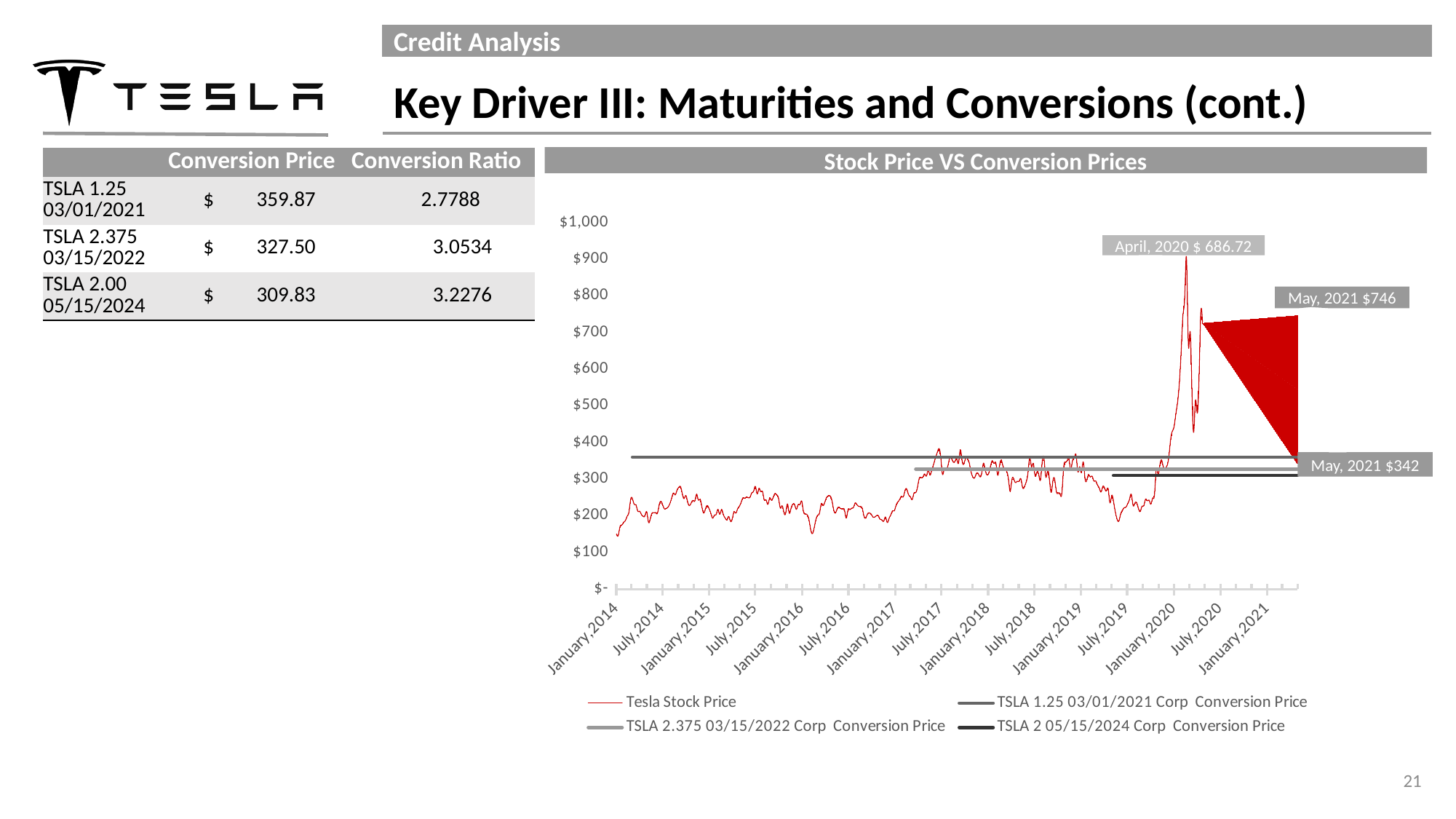
What is the title of the chart on the right side of the slide? Stock Price VS Conversion Prices In the "Stock Price VS Conversion Prices" chart, is the peak of the Tesla Stock Price line greater or less than $800? greater In the "Stock Price VS Conversion Prices" chart, what is the lower value annotated for May, 2021? $342 In the "Stock Price VS Conversion Prices" chart, what value is shown in the annotation for April, 2020? $ 686.72 In the "Stock Price VS Conversion Prices" chart, what is the higher value annotated for May, 2021? $746 In the "Stock Price VS Conversion Prices" chart, is the Tesla Stock Price at January, 2014 greater or less than $200? less How many series does the legend of the "Stock Price VS Conversion Prices" chart list? 4 In the "Stock Price VS Conversion Prices" chart, does the Tesla Stock Price overall rise or fall from January, 2014 to January, 2021? rise In the "Stock Price VS Conversion Prices" chart, what is the difference between the two May, 2021 annotated values ($746 and $342)? $404 What is the highest tick label on the y-axis of the "Stock Price VS Conversion Prices" chart? $1,000 In the "Stock Price VS Conversion Prices" chart, which annotated value is larger: April, 2020 or the upper May, 2021 value? May, 2021 ($746) What kind of chart is shown under the title "Stock Price VS Conversion Prices"? line chart